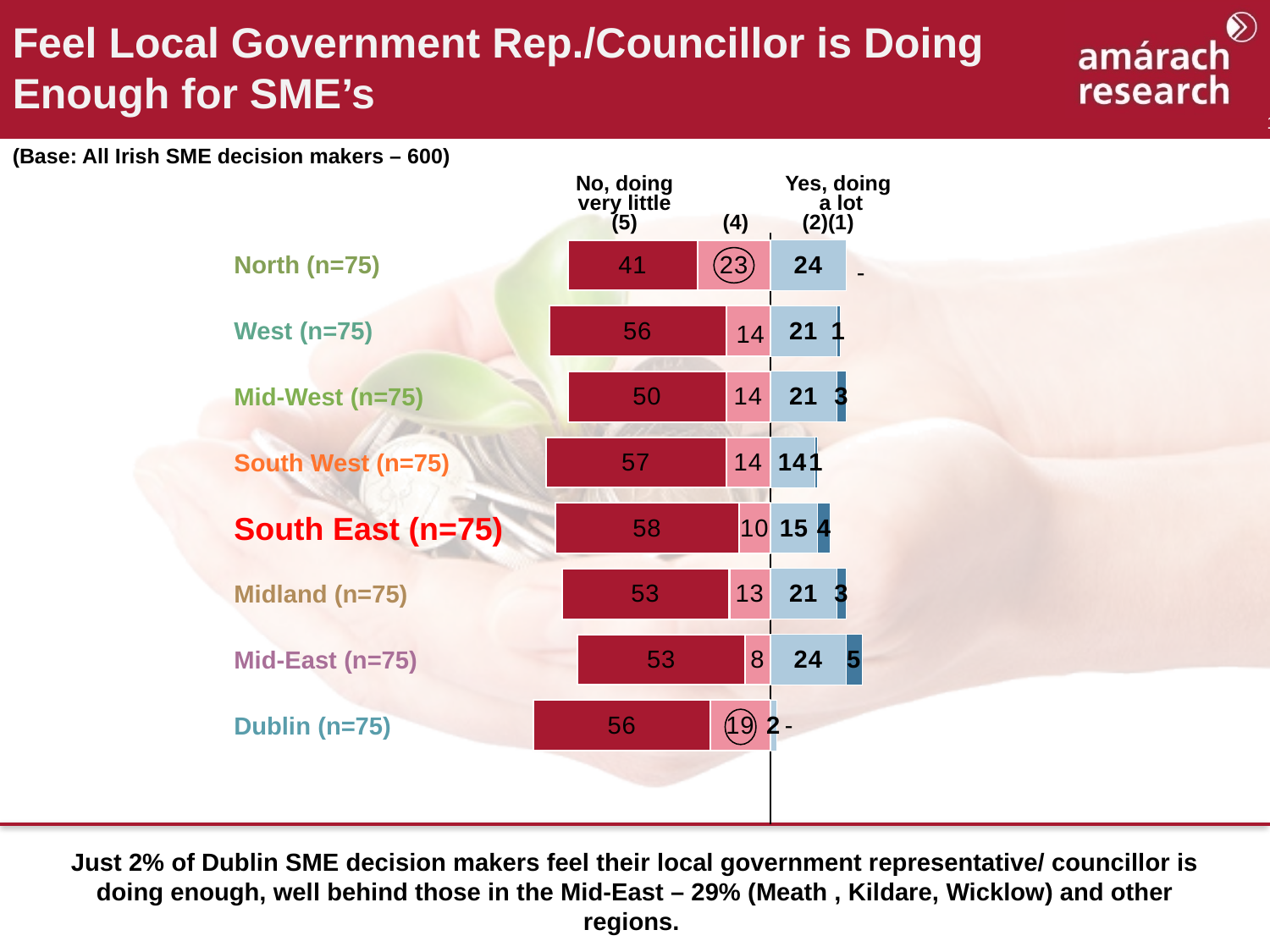
Which is larger, the (4) value for North (n=75) or for Mid-East (n=75)? North (n=75) Which region has the lowest (2) value? Dublin (n=75) Which region has the highest 'No, doing very little (5)' value? South East (n=75) What is the (2) value for Mid-East (n=75)? 24 How many regions are shown in the chart? 8 What is the total of the stacked bar for Mid-East (n=75)? 90 What percentage of North (n=75) respondents said their local government rep is doing very little (5)? 41 What is the (4) value for Dublin (n=75)? 19 Which region has the lowest 'No, doing very little (5)' value? North (n=75) What is the difference between the (5) values for South East (n=75) and North (n=75)? 17 What type of chart is shown on the slide? Stacked bar chart What is the (1) value for South East (n=75)? 4